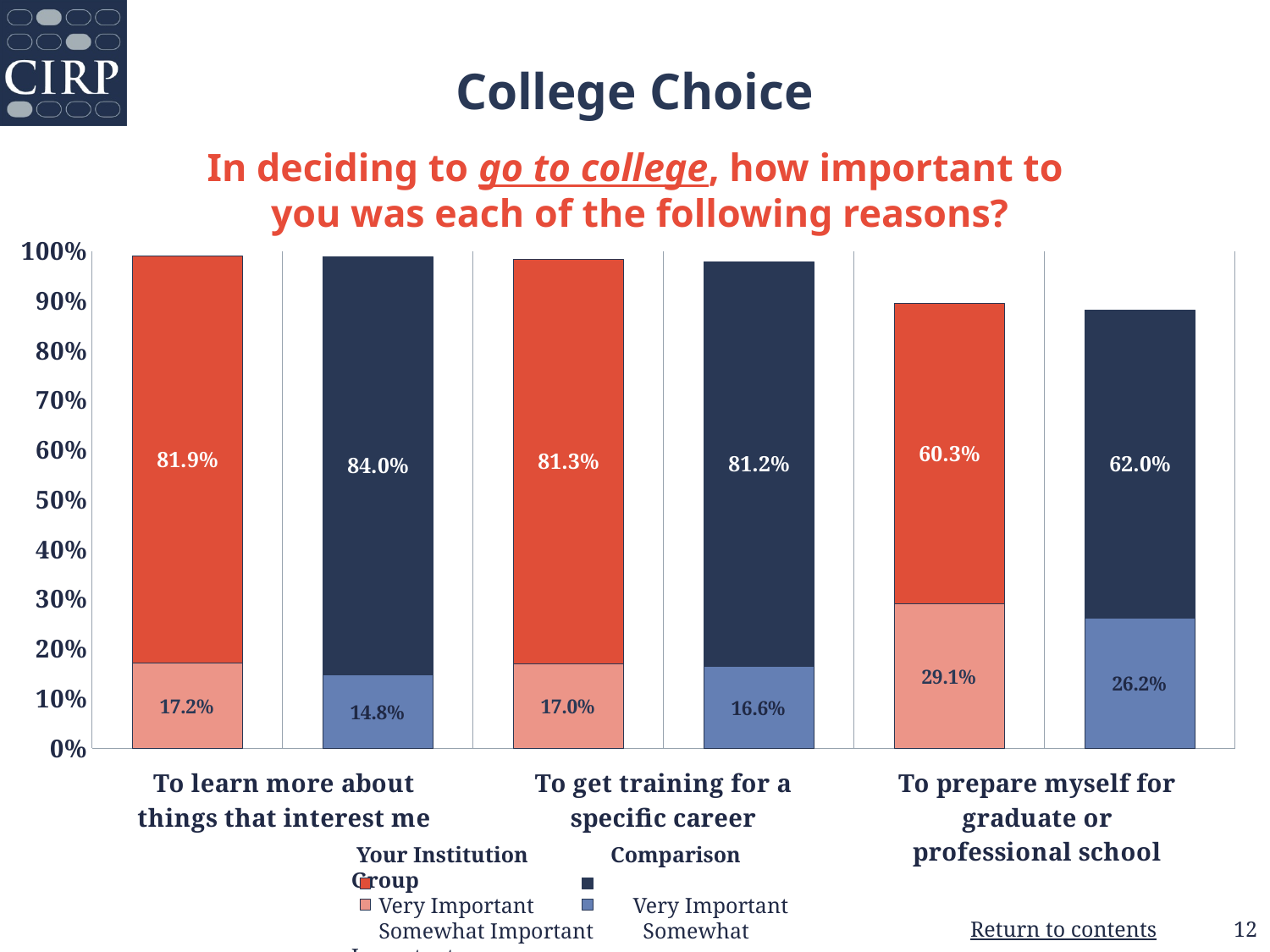
What percentage of students at Your Institution rated 'To learn more about things that interest me' as Very Important? 81.9% What type of chart is shown on the slide? Stacked bar chart For 'To prepare myself for graduate or professional school', which is larger: the Somewhat Important percentage for Your Institution or for the Comparison Group? Your Institution What is the difference between the Comparison Group's and Your Institution's Very Important percentages for 'To learn more about things that interest me'? 2.1% What is the total height of the Your Institution stacked bar for 'To prepare myself for graduate or professional school' (Very Important plus Somewhat Important)? 89.4% What is the Very Important percentage for the Comparison Group on 'To get training for a specific career'? 81.2% Which reason has the lowest Very Important percentage for Your Institution? To prepare myself for graduate or professional school Which reason has the highest Very Important percentage for the Comparison Group? To learn more about things that interest me What percentage of the Comparison Group rated 'To prepare myself for graduate or professional school' as Somewhat Important? 26.2% How many series does the chart legend list? 4 How many reasons (categories) are shown on the x axis of the chart? 3 What is the total of the Comparison Group stacked bar for 'To learn more about things that interest me'? 98.8%